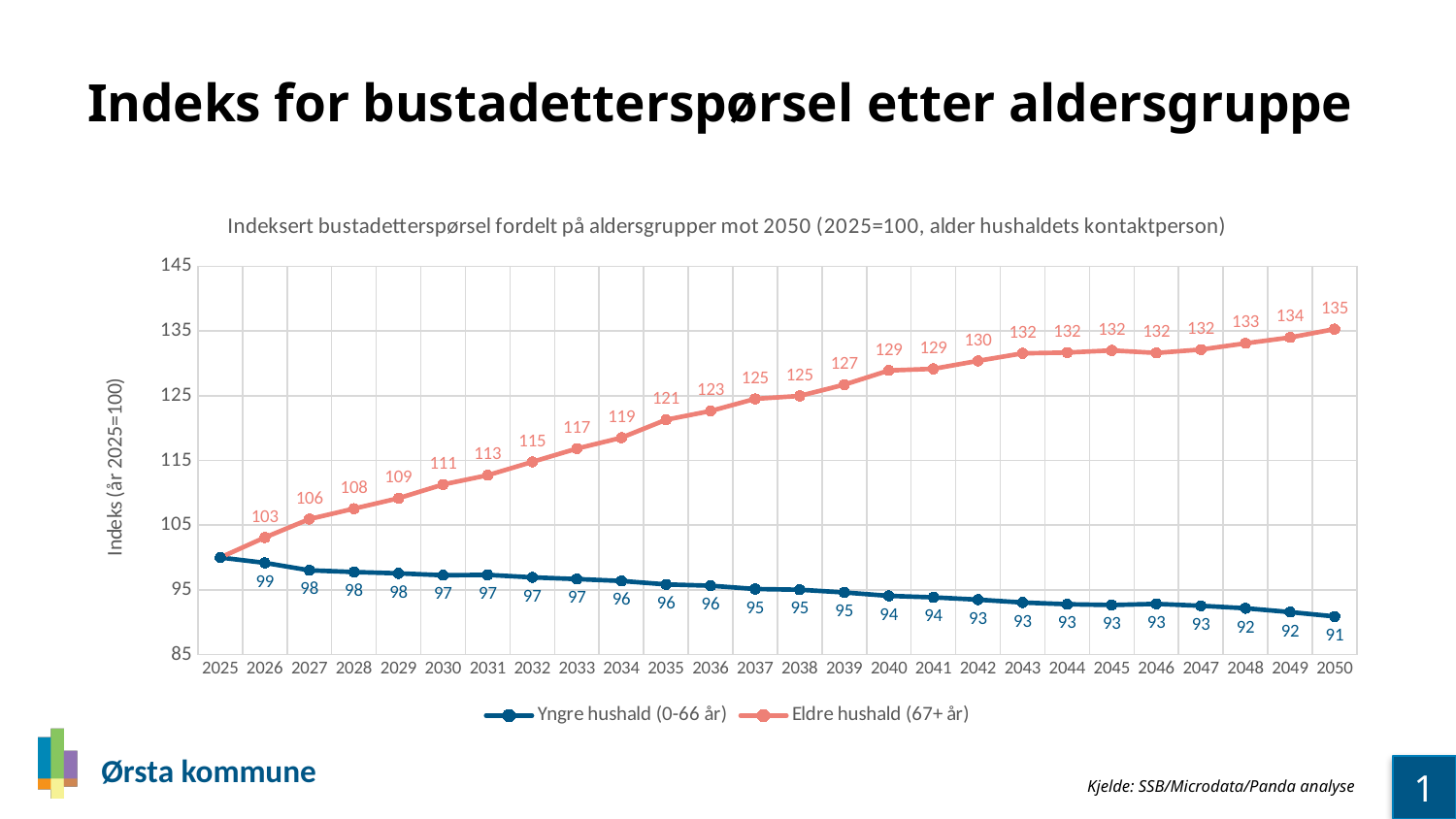
In which year does the Eldre hushald (67+ år) series reach its highest value? 2050 In which year does the Yngre hushald (0-66 år) series reach its lowest value? 2050 What is the value for Yngre hushald (0-66 år) in 2040? 94 What is the value for Eldre hushald (67+ år) in 2035? 121 Which series is higher in 2030, Yngre hushald (0-66 år) or Eldre hushald (67+ år)? Eldre hushald (67+ år) What is the difference between the Eldre hushald (67+ år) and Yngre hushald (0-66 år) values in 2050? 44 How many series does the legend list? 2 What type of chart is shown on the slide? Line chart How many years are shown on the x axis? 26 What is the value for Yngre hushald (0-66 år) in 2050? 91 What is the value for Eldre hushald (67+ år) in 2050? 135 Does the Yngre hushald (0-66 år) series rise or fall from 2025 to 2050? Fall